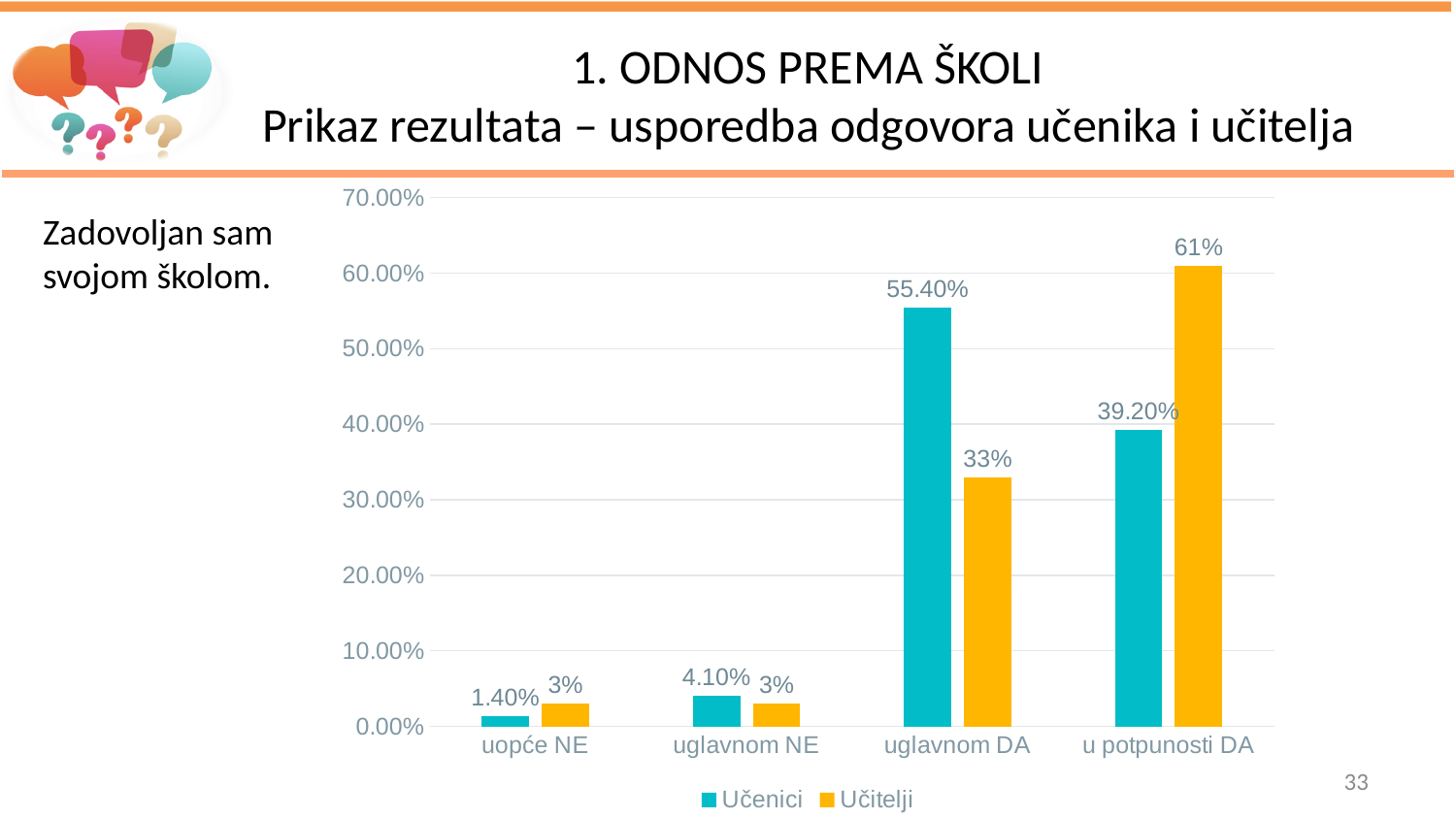
What kind of chart is shown on the slide? bar chart What is the value for Učitelji in the 'u potpunosti DA' category? 61% In the 'u potpunosti DA' category, which series has the larger value, Učenici or Učitelji? Učitelji Which category has the highest value for Učitelji? u potpunosti DA Which category has the lowest value for Učenici? uopće NE Which category has the highest value for Učenici? uglavnom DA How many series does the legend list? 2 How many categories are shown on the x axis? 4 What is the value for Učitelji in the 'uglavnom DA' category? 33% What is the value for Učenici in the 'uopće NE' category? 1.40% What is the difference between the Učenici and Učitelji values in the 'uglavnom DA' category? 22.40% What is the value for Učenici in the 'uglavnom DA' category? 55.40%